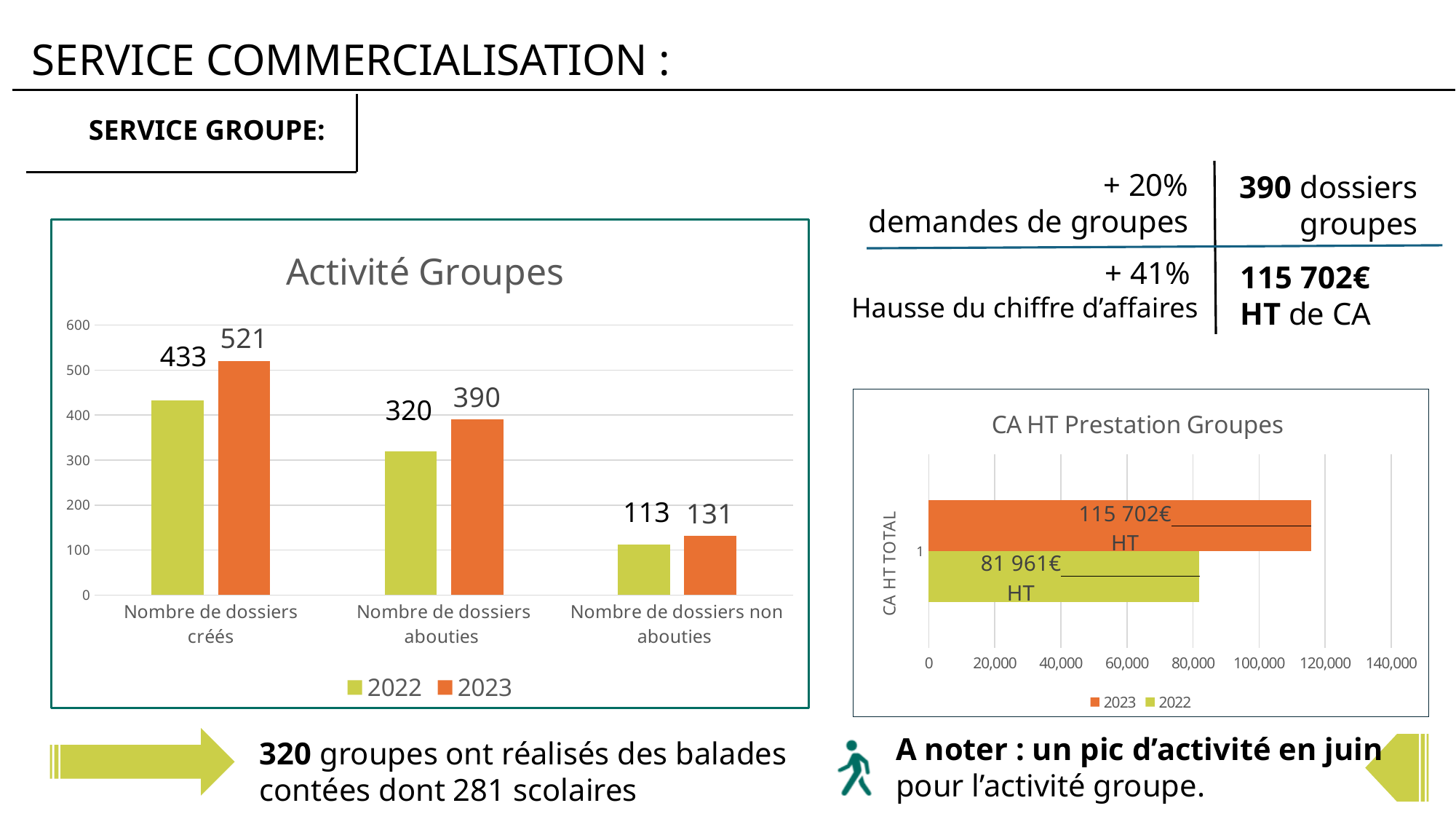
In the 'Activité Groupes' chart, what is the difference between the 2023 and 2022 values for 'Nombre de dossiers créés'? 88 In the 'CA HT Prestation Groupes' chart, is the value for 2023 greater or less than 100,000? greater In the 'Activité Groupes' chart, what is the value for 'Nombre de dossiers abouties' in 2022? 320 In the 'CA HT Prestation Groupes' chart, what is the value for 2022? 81 961€ HT In the 'Activité Groupes' chart, which is larger: the 2022 value for 'Nombre de dossiers abouties' or the 2023 value for 'Nombre de dossiers non abouties'? 2022 value for Nombre de dossiers abouties In the 'Activité Groupes' chart, what is the value for 'Nombre de dossiers créés' in 2023? 521 In the 'Activité Groupes' chart, how many series does the legend list? 2 In the 'Activité Groupes' chart, how many categories are shown on the x axis? 3 In the 'CA HT Prestation Groupes' chart, which colour represents 2023? Orange In the 'Activité Groupes' chart, what is the value for 'Nombre de dossiers non abouties' in 2023? 131 In the 'Activité Groupes' chart, which category has the lowest value for 2022? Nombre de dossiers non abouties What kind of chart is 'CA HT Prestation Groupes'? Bar chart